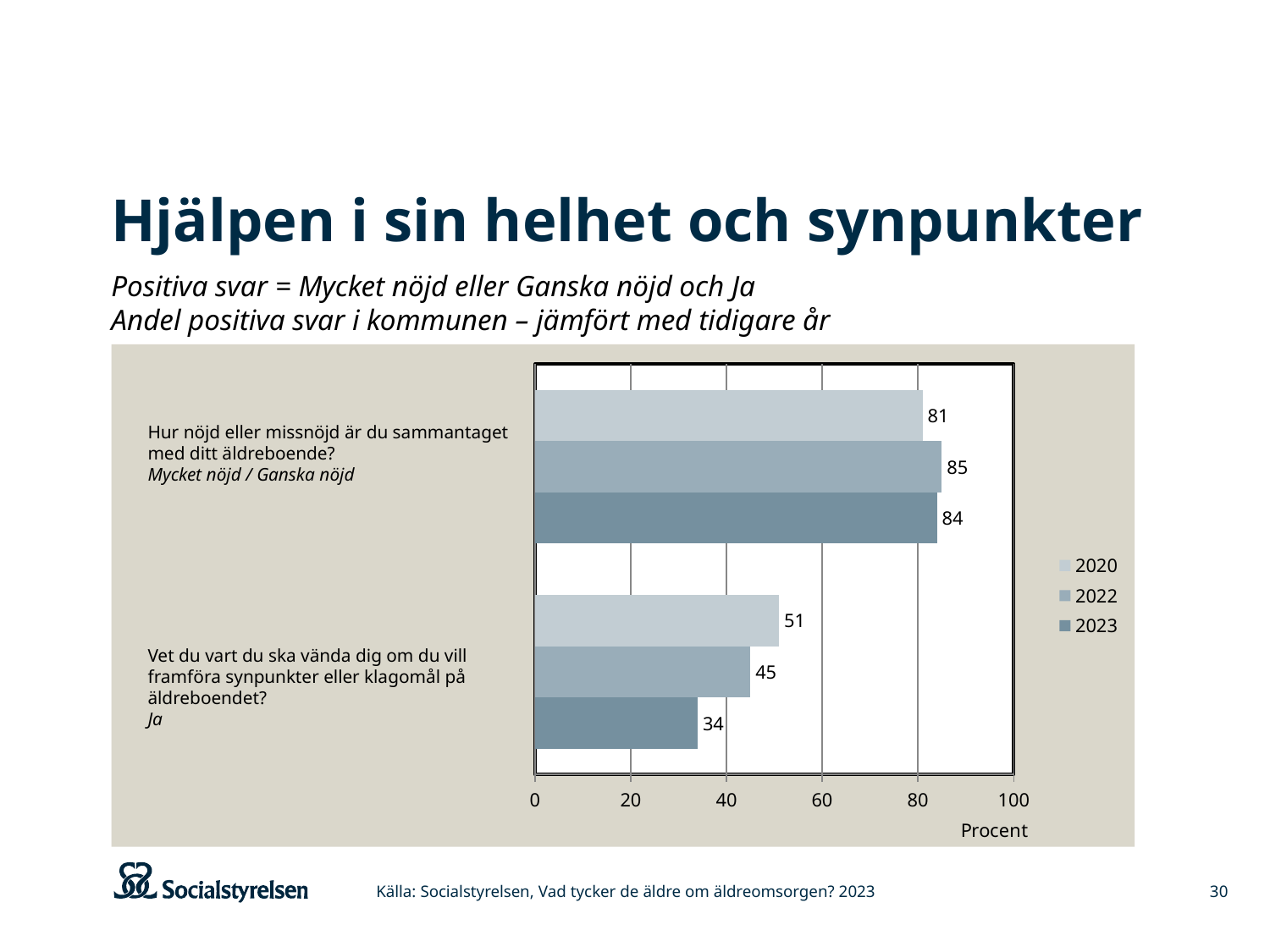
Which year has the lowest value for the question about knowing where to turn to give feedback or complaints? 2023 What is the label on the horizontal axis of the chart? Procent What is the 2020 value for the question about knowing where to turn to give feedback or complaints (Ja)? 51 What is the difference between the 2020 and 2023 values for the question about knowing where to turn to give feedback or complaints? 17 What is the 2022 value for the question about how satisfied respondents are overall with their elderly care home (Mycket nöjd / Ganska nöjd)? 85 How many series does the legend list? 3 What kind of chart is shown on the slide? bar chart Which year has the highest value for the question about overall satisfaction with the elderly care home? 2022 How do the values for the question about knowing where to turn to give feedback or complaints change from 2020 to 2023? They fall What is the 2023 value for the question about overall satisfaction with the elderly care home? 84 Is the 2022 value for the question about knowing where to turn to give feedback or complaints larger or smaller than the 2020 value? smaller What is the 2023 value for the question about knowing where to turn to give feedback or complaints (Ja)? 34